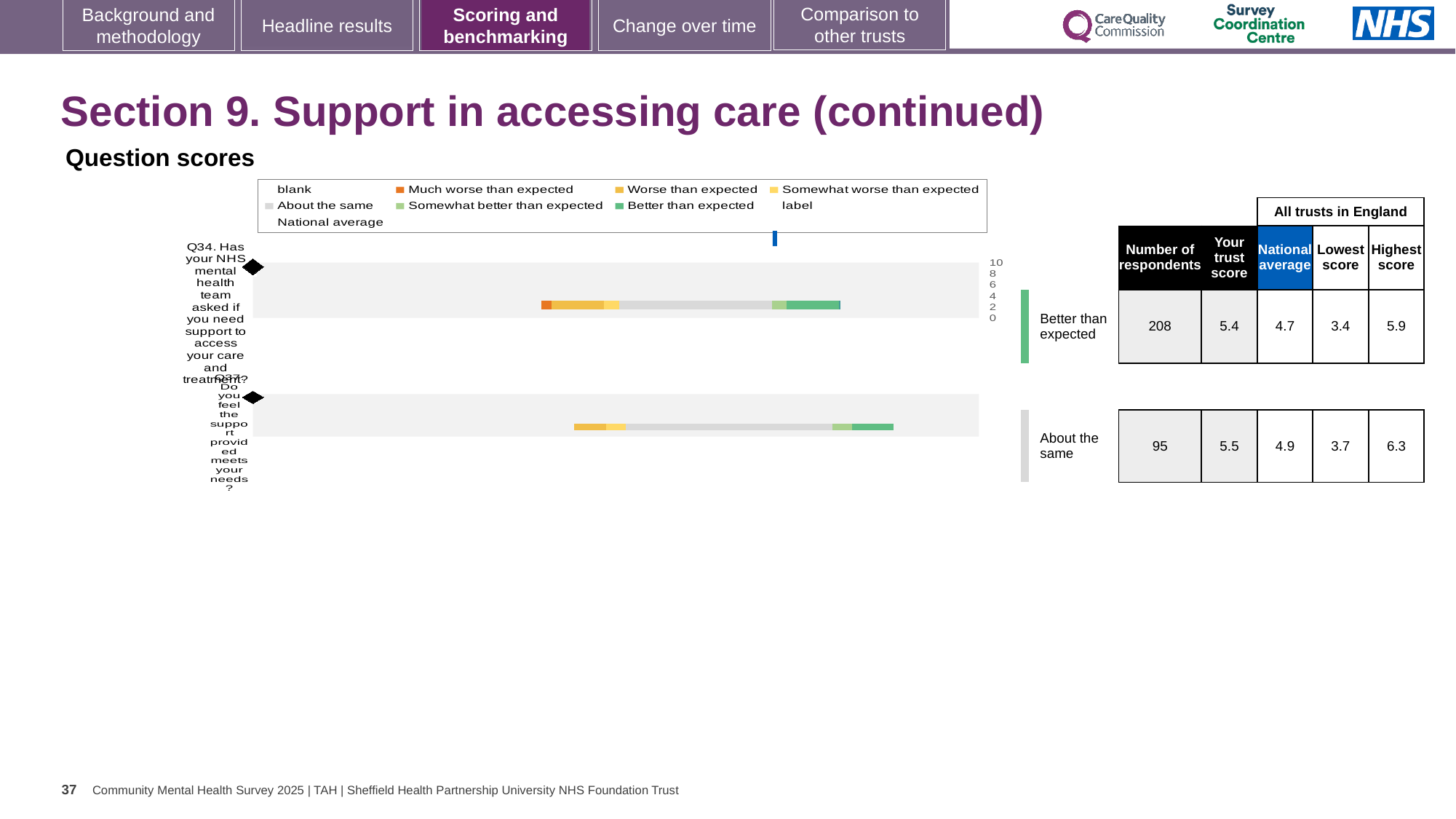
What is the national average for Q34? 4.7 What kind of chart is used to show the question scores on this slide? bar chart Which question has the higher trust score, Q34 or Q37? Q37 What is the number of respondents for Q34? 208 What is the difference between the highest score and the lowest score for Q34? 2.5 What is the highest score among all trusts in England for Q37? 6.3 How many survey questions are plotted as bars in the question scores chart? 2 By how much does the trust score for Q37 exceed the national average for Q37? 0.6 Which benchmark category is shown for Q34 (Has your NHS mental health team asked if you need support to access your care and treatment?)? Better than expected Which benchmark category is shown for Q37 (Do you feel the support provided meets your needs?)? About the same What is the maximum value shown on the score axis of the chart? 10 What is the trust score for Q37? 5.5